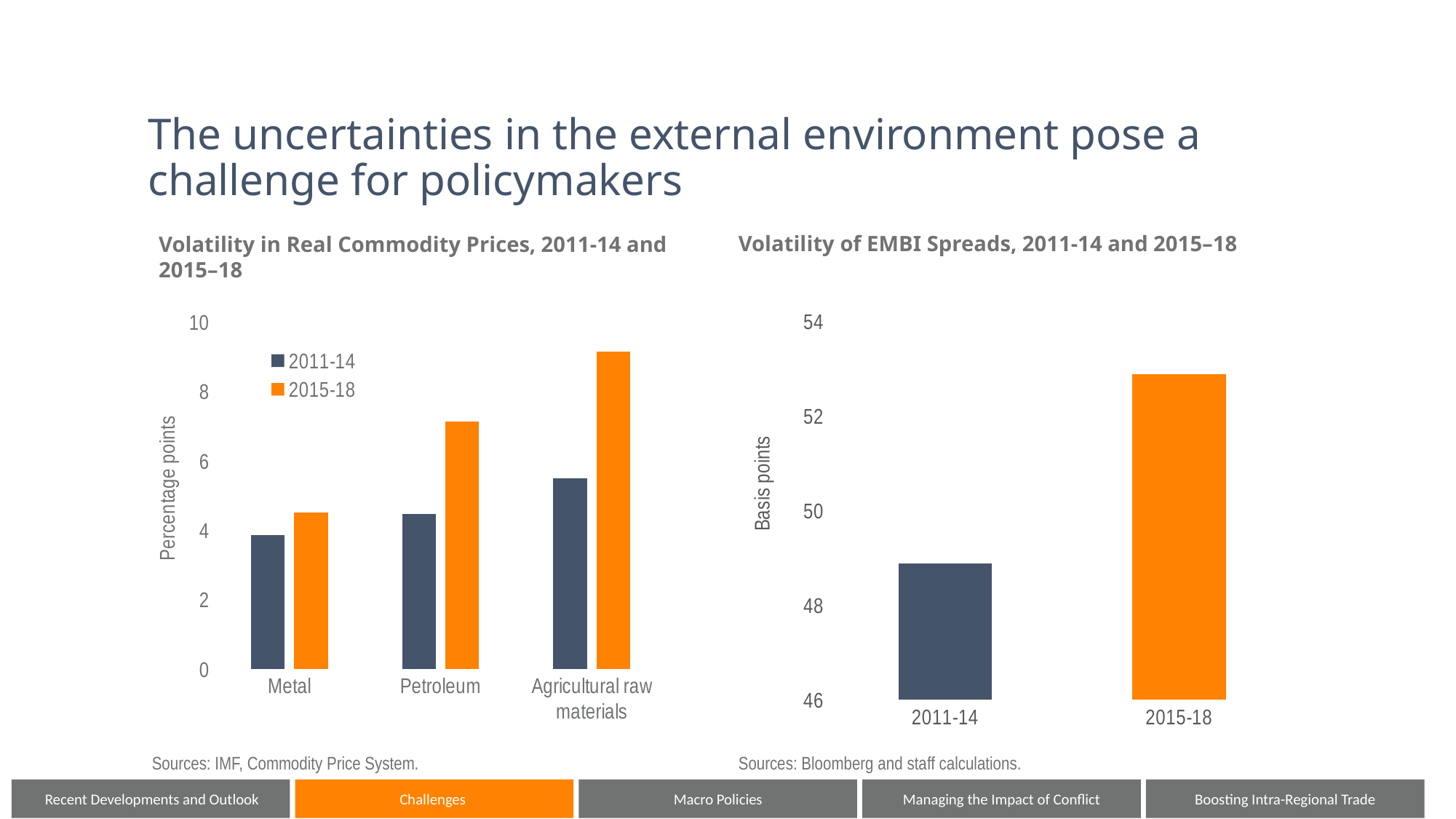
How many series does the legend of the 'Volatility in Real Commodity Prices' chart list? 2 What is the y-axis label of the 'Volatility of EMBI Spreads' chart? Basis points How many categories are shown on the x axis of the 'Volatility in Real Commodity Prices' chart? 3 In the 'Volatility in Real Commodity Prices' chart, is the 2015-18 value for Agricultural raw materials greater or less than 8? greater What kind of chart is the 'Volatility in Real Commodity Prices, 2011-14 and 2015–18' chart? Bar chart In the 'Volatility in Real Commodity Prices' chart, which category has the lowest 2011-14 value? Metal In the 'Volatility in Real Commodity Prices' chart, which is larger for Petroleum: the 2011-14 value or the 2015-18 value? 2015-18 In the 'Volatility of EMBI Spreads, 2011-14 and 2015–18' chart, which period has the higher value? 2015-18 In the 'Volatility in Real Commodity Prices' chart, which category has the highest 2015-18 value? Agricultural raw materials In the 'Volatility of EMBI Spreads' chart, is the value for 2011-14 greater or less than 50? less What is the y-axis label of the 'Volatility in Real Commodity Prices' chart? Percentage points